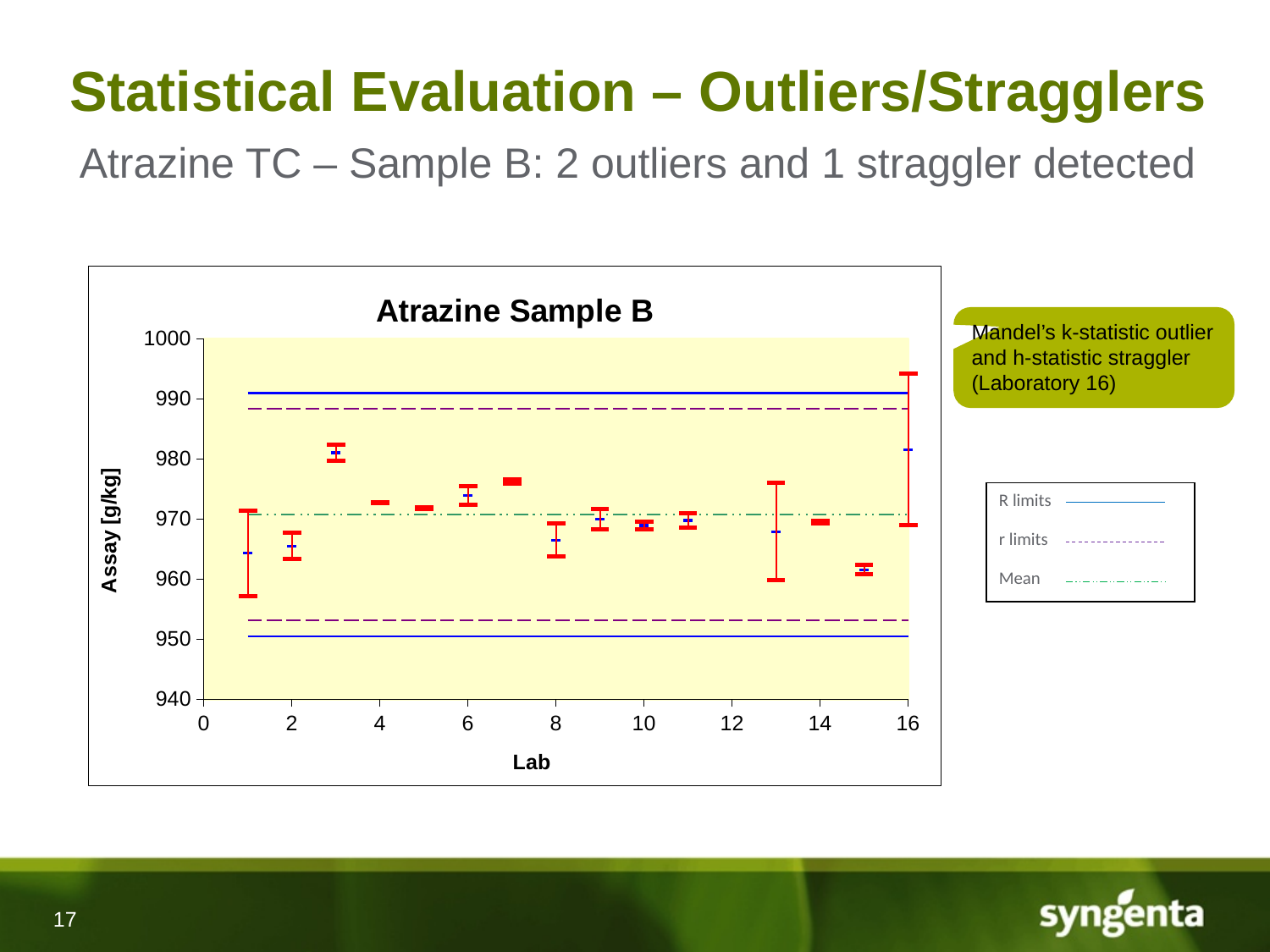
Is the value for Lab 3 greater or less than 970? greater Is the value for Lab 15 greater or less than 970? less Which has the larger assay value, Lab 3 or Lab 15? Lab 3 Which lab has the widest error bar in the chart? Lab 16 Is the value for Lab 1 greater or less than 970? less What is the label of the y axis of the chart? Assay [g/kg] How many labs have a plotted result in the chart? 15 What is the title of the chart? Atrazine Sample B What kind of chart is shown on the slide? Scatter chart with error bars Which has the larger assay value, Lab 7 or Lab 8? Lab 7 How many entries does the chart's legend list? 3